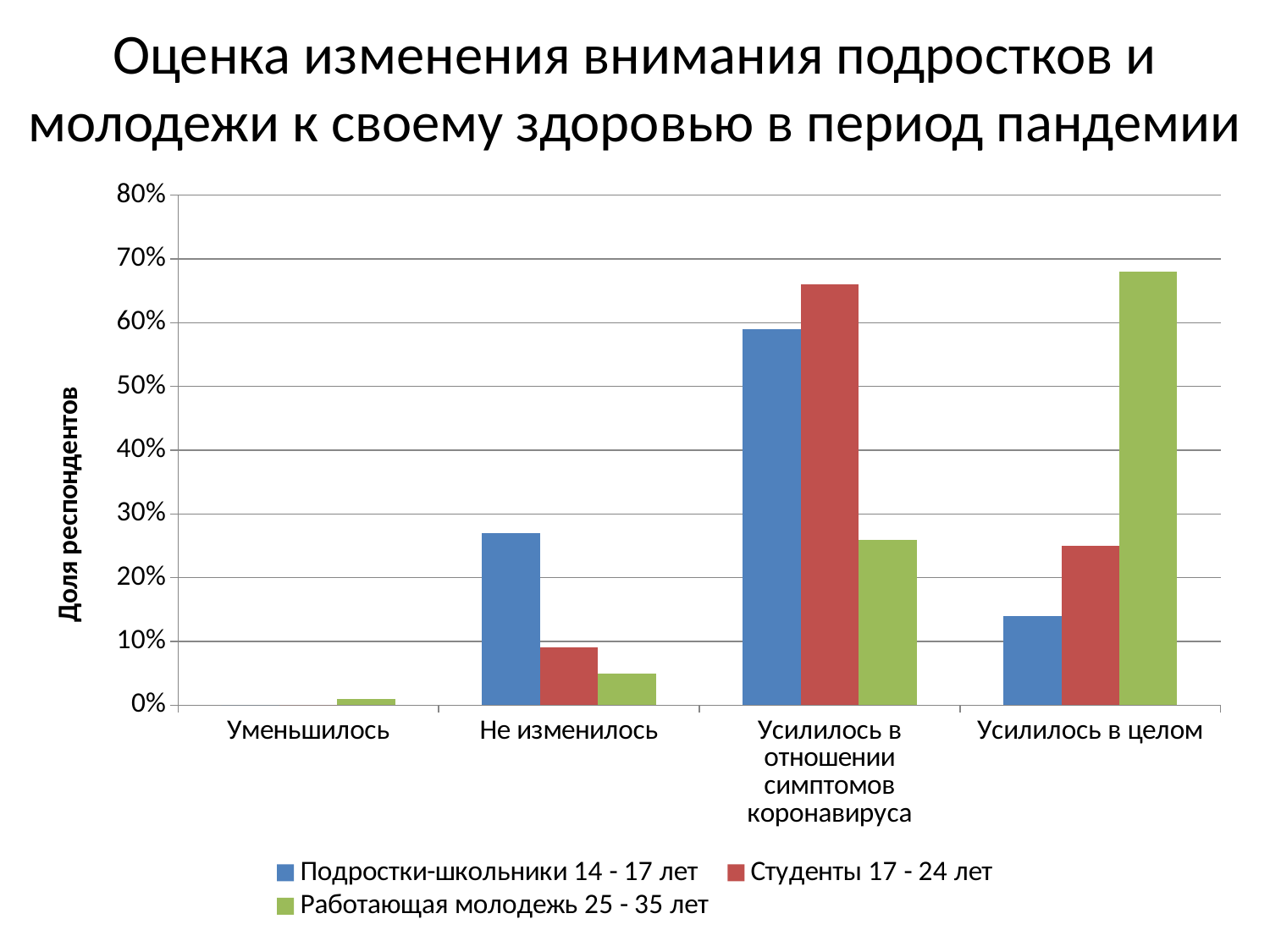
How many categories are shown on the x axis? 4 In the category Усилилось в целом, which series has the larger value: Подростки-школьники 14 - 17 лет or Студенты 17 - 24 лет? Студенты 17 - 24 лет What is the label of the vertical axis? Доля респондентов Is the value for Студенты 17 - 24 лет in the category Усилилось в отношении симптомов коронавируса greater or less than 60%? greater Is the value for Подростки-школьники 14 - 17 лет in the category Не изменилось greater or less than 30%? less In the category Не изменилось, which series has the larger value: Подростки-школьники 14 - 17 лет or Работающая молодежь 25 - 35 лет? Подростки-школьники 14 - 17 лет Which category has the lowest value for Студенты 17 - 24 лет? Уменьшилось What kind of chart is shown on the slide? bar chart How many series does the legend list? 3 Which category has the highest value for Подростки-школьники 14 - 17 лет? Усилилось в отношении симптомов коронавируса Which category has the highest value for Работающая молодежь 25 - 35 лет? Усилилось в целом Is the value for Работающая молодежь 25 - 35 лет in the category Усилилось в целом greater or less than 60%? greater